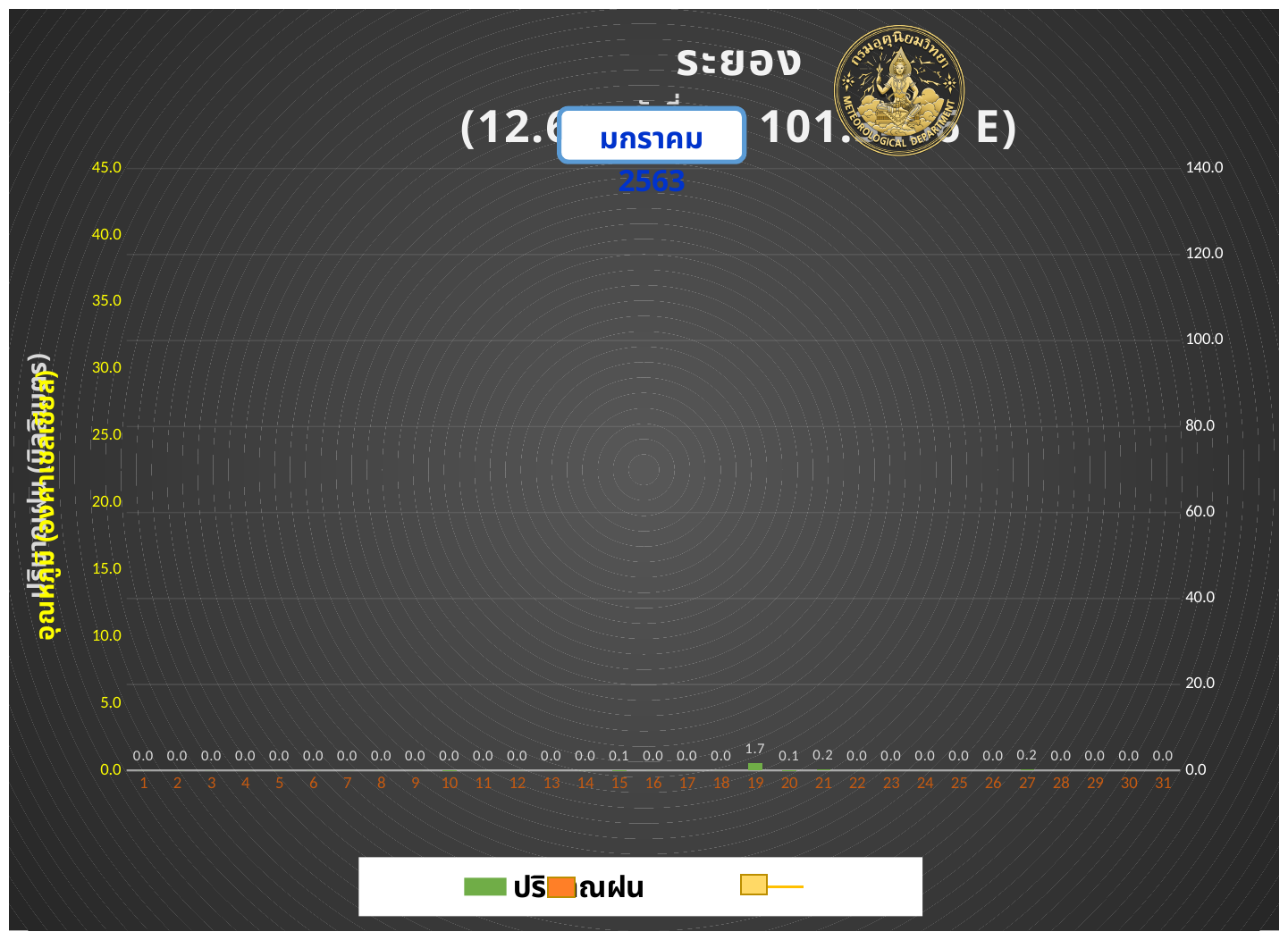
What is the rainfall value shown for day 27? 0.2 What kind of chart is used to show the rainfall values? Bar chart Which day has the highest rainfall value? 19 How many days are shown on the x axis? 31 What is the highest tick value on the right vertical axis? 140.0 Which has the larger rainfall value, day 19 or day 27? Day 19 What is the difference between the rainfall values for day 19 and day 21? 1.5 What is the rainfall value shown for day 15? 0.1 What is the highest tick value on the left vertical axis? 45.0 What is the rainfall value shown for day 21? 0.2 What is the rainfall value shown for day 19? 1.7 Is the rainfall value for day 19 greater or less than 5.0 on the left axis? less